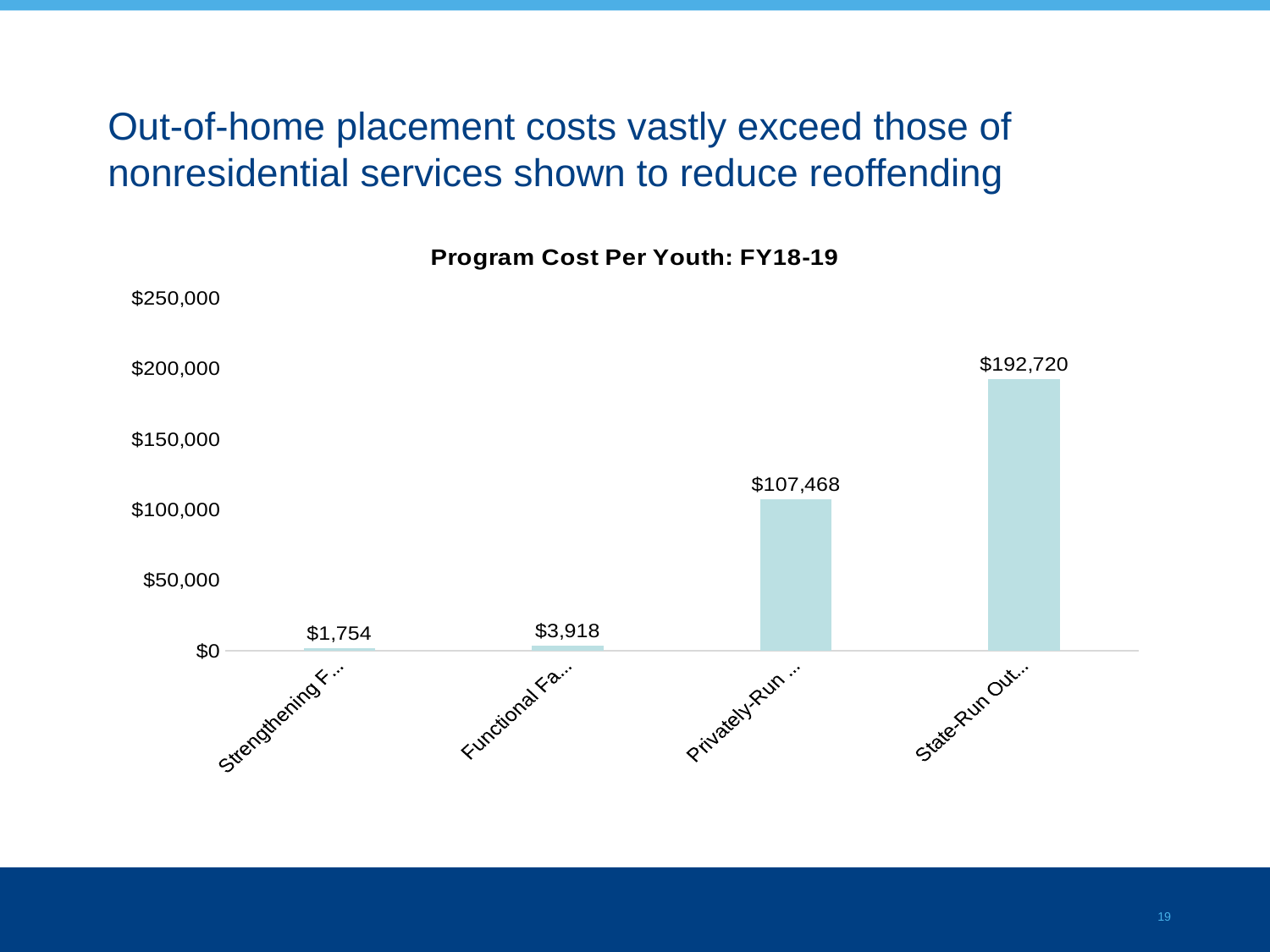
Which category has the lowest program cost per youth? Strengthening F... (the leftmost bar) Which is larger, the value for "Functional Fa..." or the value for "Strengthening F..."? Functional Fa... Which category has the highest program cost per youth? State-Run Out... (the rightmost bar) What is the title of the chart? Program Cost Per Youth: FY18-19 What is the value of the rightmost bar, labeled "State-Run Out..."? $192,720 What is the difference between the "State-Run Out..." bar and the "Privately-Run ..." bar? $85,252 What kind of chart is shown on the slide? Bar chart How many bars (categories) does the chart show? 4 What is the value of the second bar from the left, labeled "Functional Fa..."? $3,918 What is the value of the third bar from the left, labeled "Privately-Run ..."? $107,468 Is the value for "Privately-Run ..." greater or less than $150,000? less What is the value of the first bar from the left, labeled "Strengthening F..."? $1,754